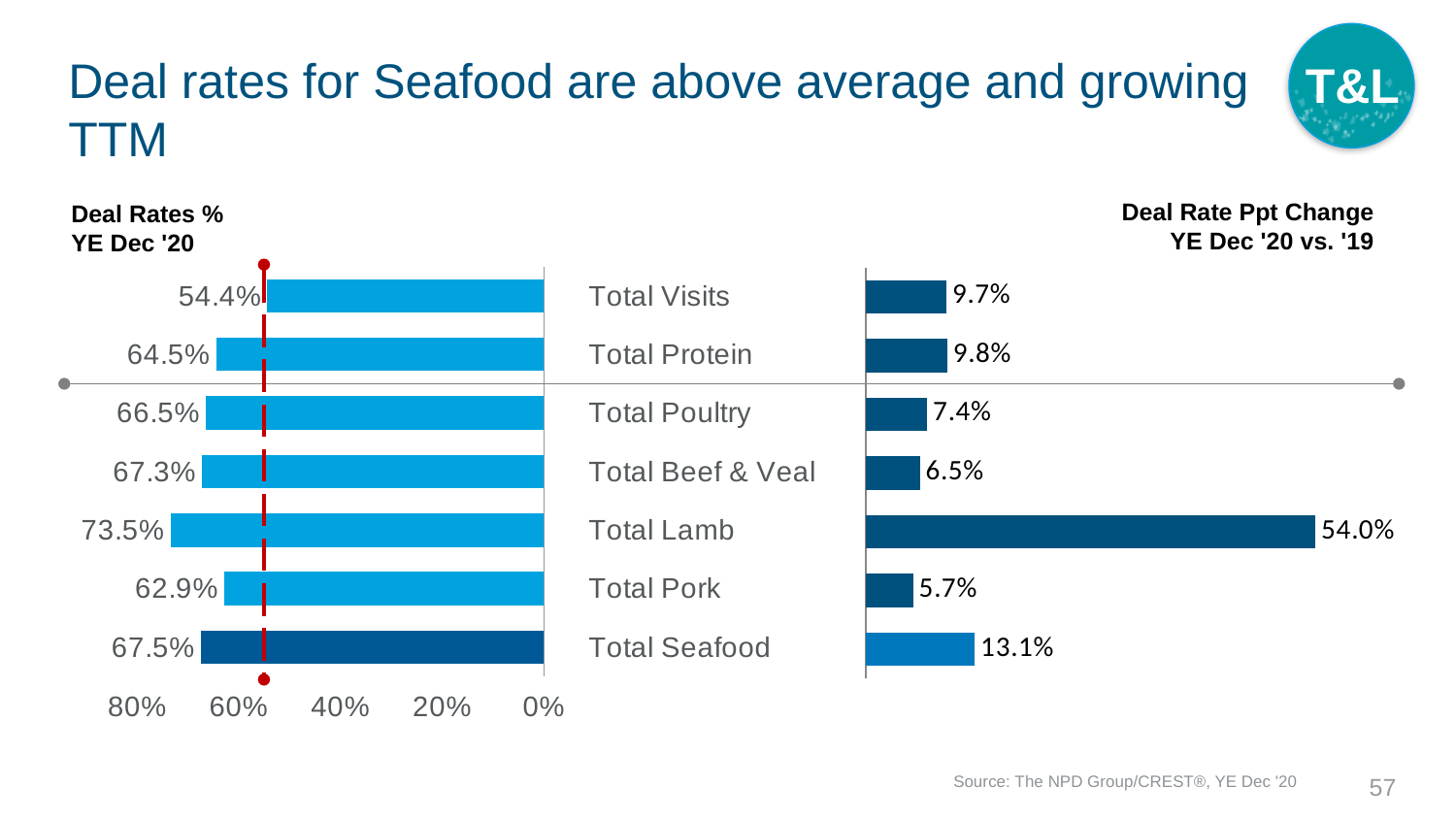
How many categories are shown in the Deal Rates % YE Dec '20 chart? 7 In the Deal Rates % YE Dec '20 chart, what is the difference between Total Lamb and Total Pork? 10.6 percentage points In the Deal Rates % YE Dec '20 chart, which category has the highest deal rate? Total Lamb In the Deal Rate Ppt Change YE Dec '20 vs. '19 chart, which category has the smallest change? Total Pork In the Deal Rate Ppt Change YE Dec '20 vs. '19 chart, which is larger: Total Poultry or Total Beef & Veal? Total Poultry In the Deal Rate Ppt Change YE Dec '20 vs. '19 chart, which category has the largest change? Total Lamb In the Deal Rates % YE Dec '20 chart, what is the value for Total Seafood? 67.5% What type of chart is the Deal Rates % YE Dec '20 chart? Bar chart In the Deal Rates % YE Dec '20 chart, what is the value for Total Visits? 54.4% In the Deal Rates % YE Dec '20 chart, which category has the lowest deal rate? Total Visits In the Deal Rate Ppt Change YE Dec '20 vs. '19 chart, what is the difference between Total Seafood and Total Visits? 3.4 percentage points In the Deal Rate Ppt Change YE Dec '20 vs. '19 chart, what is the value for Total Seafood? 13.1%